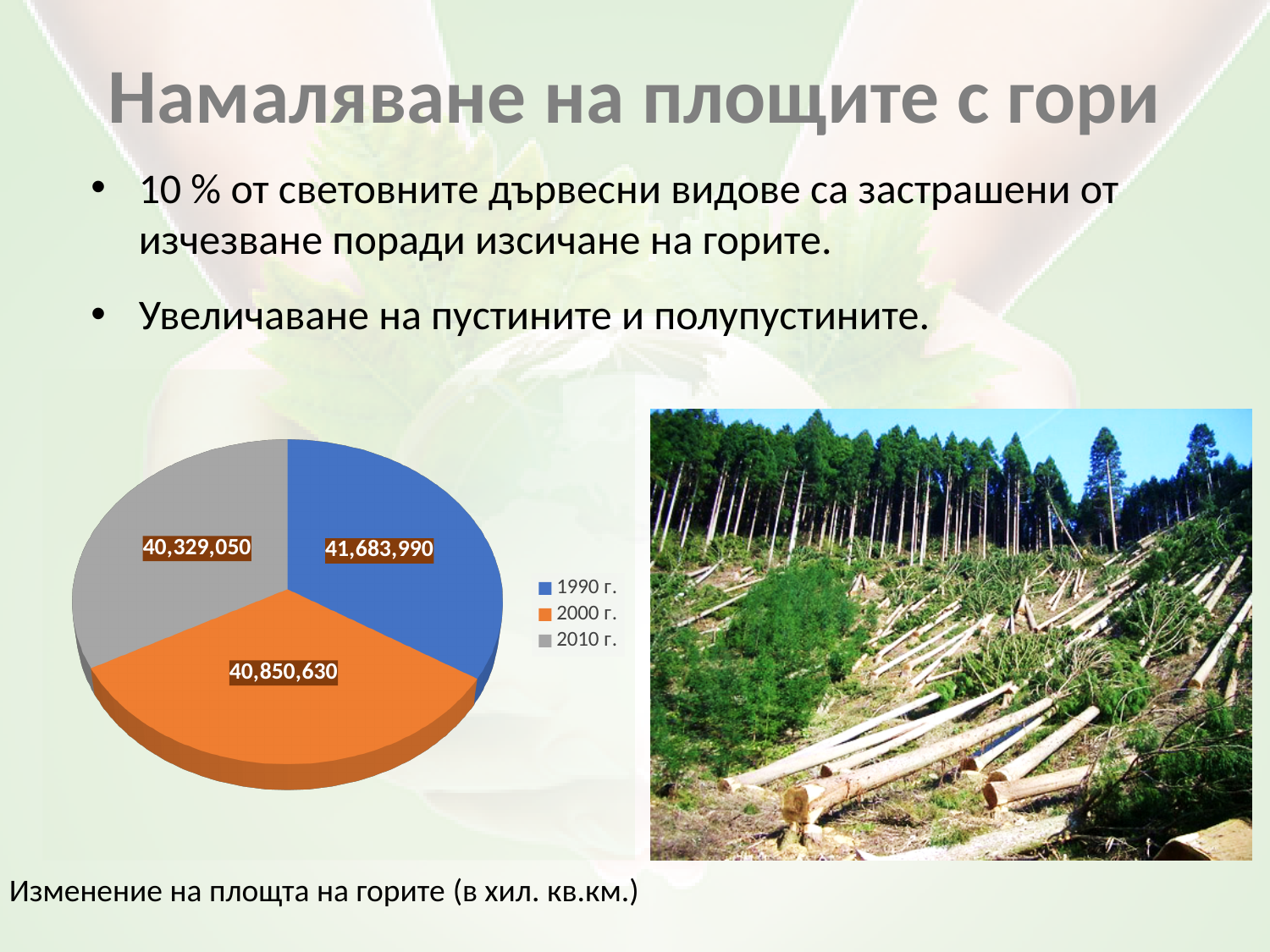
What is the value shown for 1990 г. in the pie chart? 41,683,990 What is the difference between the values for 1990 г. and 2010 г.? 1,354,940 Which year has the largest value in the pie chart? 1990 г. What is the value shown for 2000 г. in the pie chart? 40,850,630 Which year has the smallest value in the pie chart? 2010 г. How many slices does the pie chart have? 3 Which is larger, the value for 2000 г. or the value for 2010 г.? 2000 г. How many entries does the legend of the pie chart list? 3 What is the value shown for 2010 г. in the pie chart? 40,329,050 What kind of chart is shown on the slide? Pie chart Which colour represents 2000 г. in the pie chart? Orange Do the values in the pie chart rise or fall from 1990 г. to 2010 г.? Fall